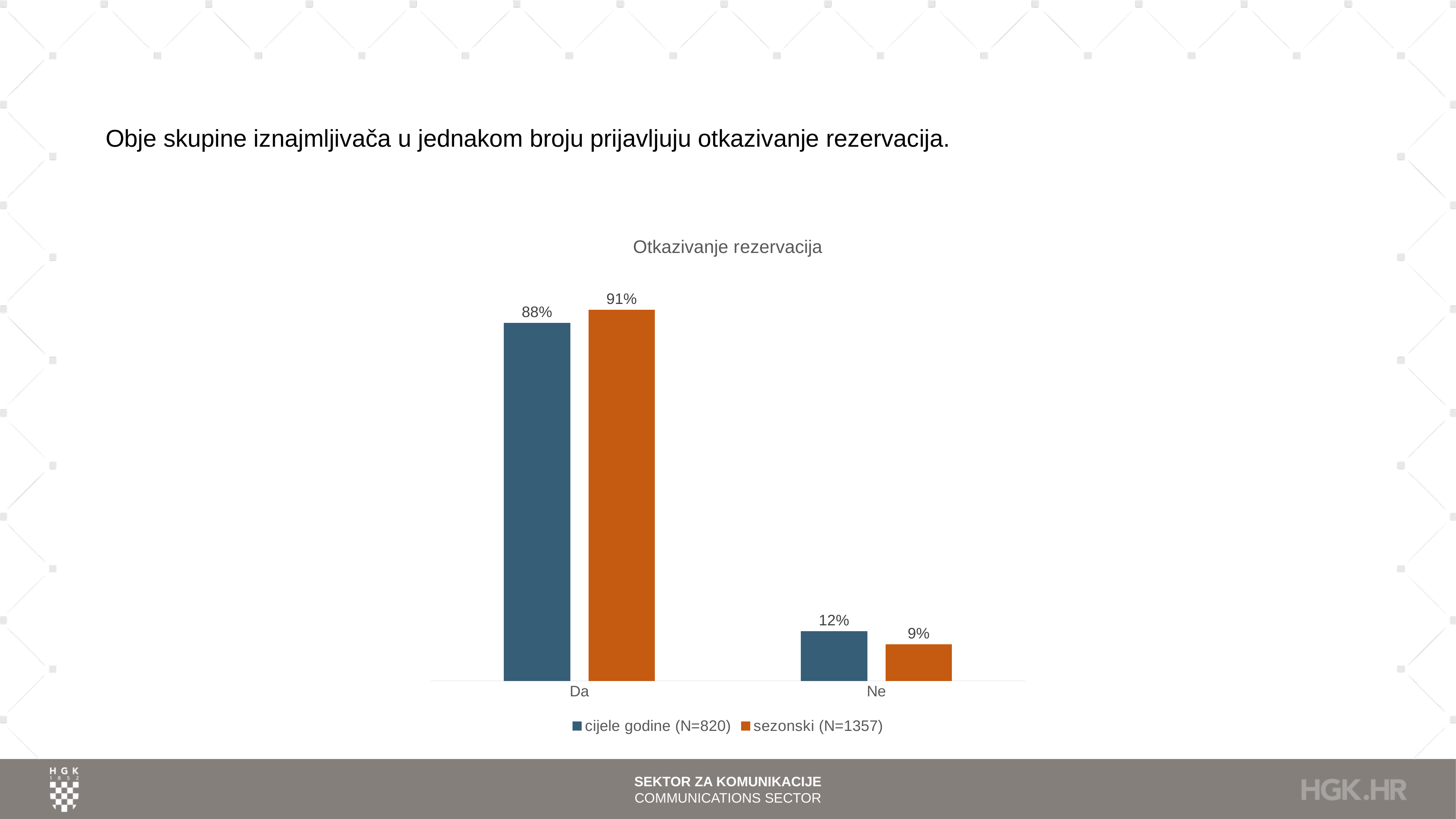
Which category has the lowest value for 'sezonski (N=1357)'? Ne Which series has the higher value in the 'Da' category? sezonski (N=1357) What is the value for 'cijele godine (N=820)' in the 'Da' category? 88% What is the value for 'sezonski (N=1357)' in the 'Ne' category? 9% What is the value for 'cijele godine (N=820)' in the 'Ne' category? 12% What is the difference between the 'cijele godine (N=820)' and 'sezonski (N=1357)' values in the 'Ne' category? 3% What is the value for 'sezonski (N=1357)' in the 'Da' category? 91% What type of chart is shown on the slide? Bar chart How many categories are shown on the x axis? 2 How many series does the legend list? 2 Which series has the higher value in the 'Ne' category? cijele godine (N=820) What is the difference between the 'sezonski (N=1357)' and 'cijele godine (N=820)' values in the 'Da' category? 3%